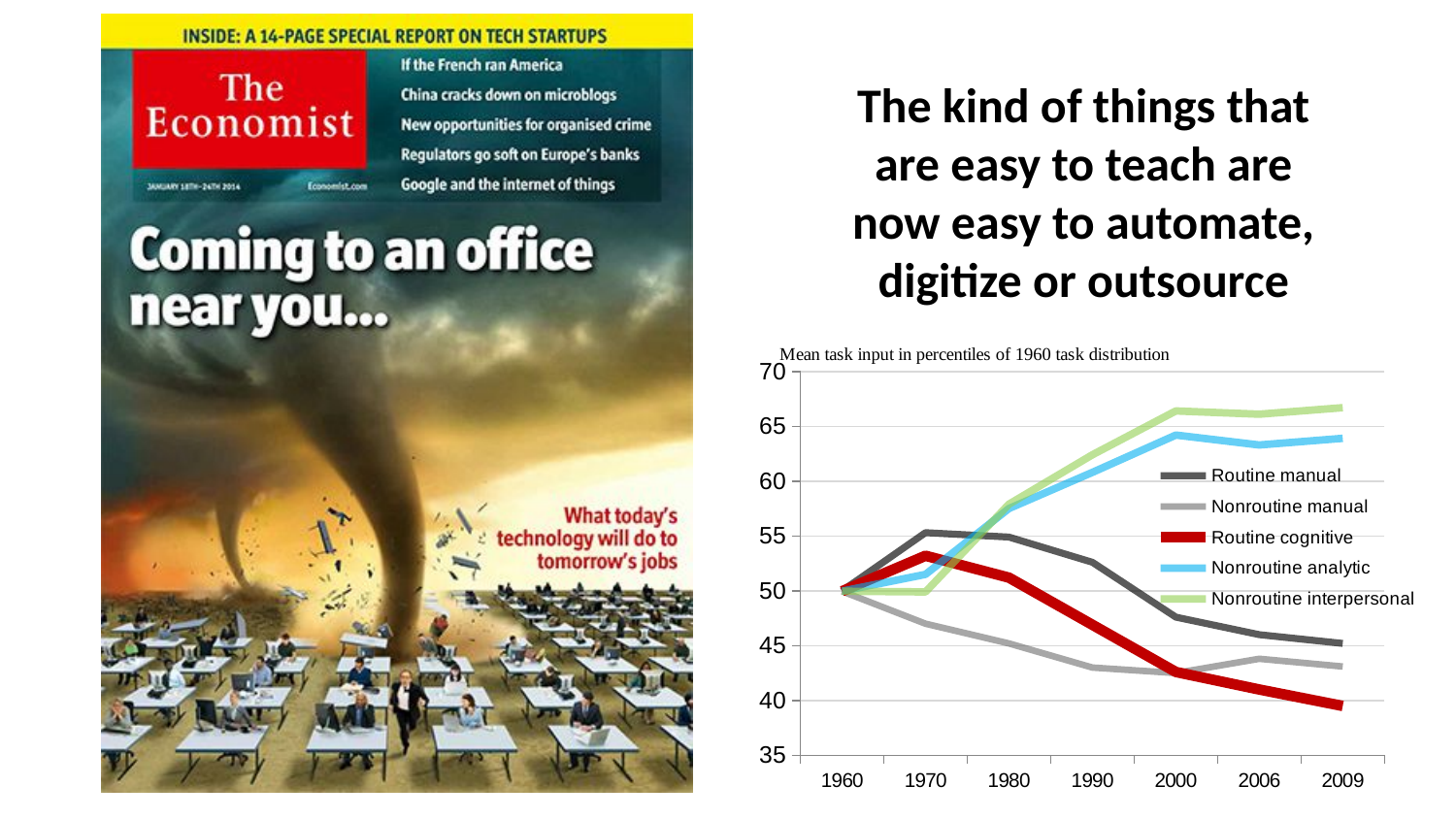
Is the value for Nonroutine interpersonal in 2000 greater or less than 60? greater Does the Nonroutine interpersonal line rise or fall from 1960 to 2009? rise Which series has the lowest value in 2009? Routine cognitive Which series has the highest value in 2009? Nonroutine interpersonal How many series does the chart's legend list? 5 How many years are marked along the x axis of the chart? 7 In 1970, which is larger: Routine manual or Nonroutine manual? Routine manual Does the Routine cognitive line rise or fall from 1960 to 2009? fall Is the value for Nonroutine manual in 1990 greater or less than 45? less What is the title printed above the chart? Mean task input in percentiles of 1960 task distribution Is the value for Routine cognitive in 2009 greater or less than 45? less What kind of chart is shown on the slide? line chart